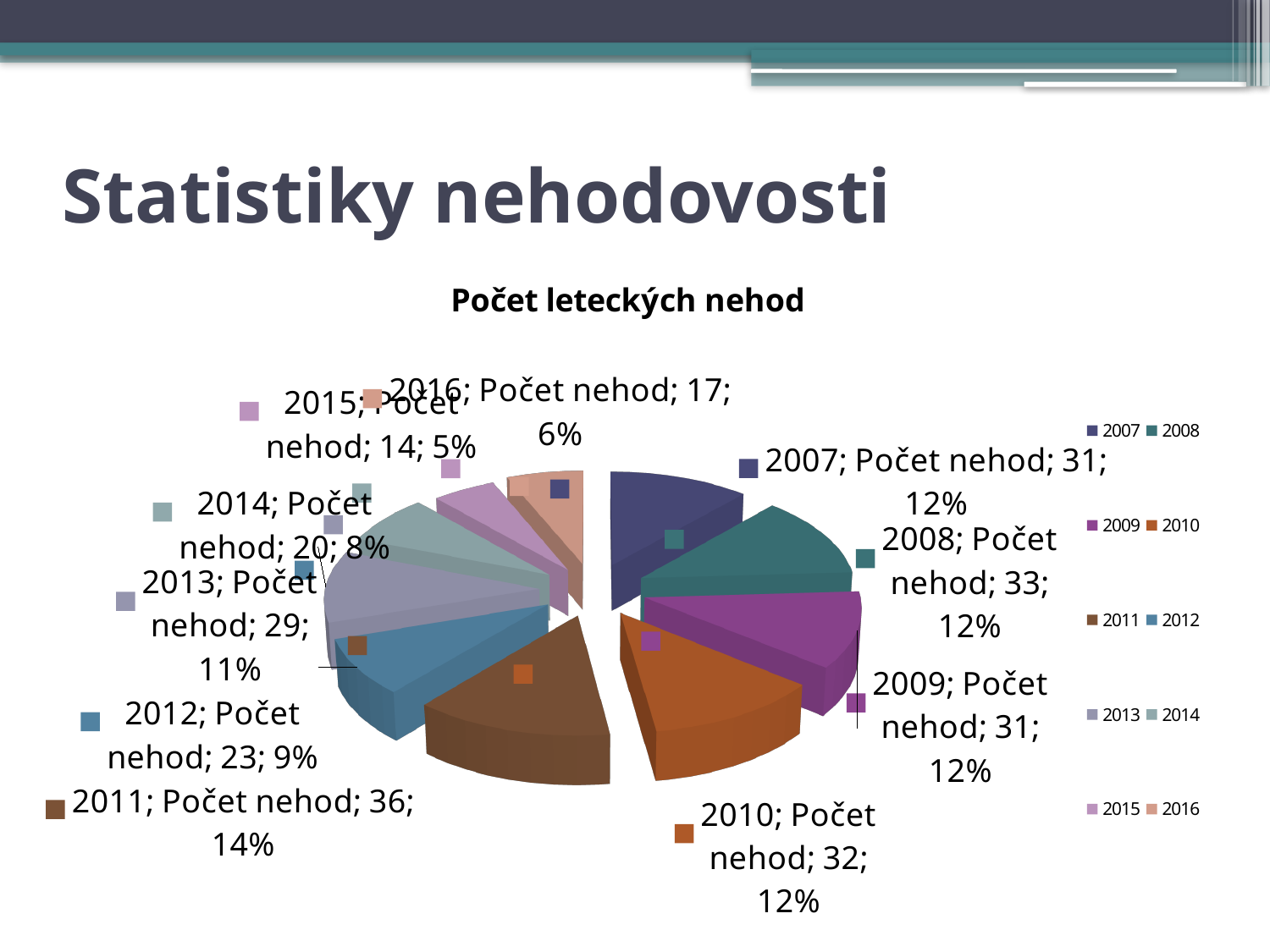
Which year has the lowest number of accidents? 2015 What is the number of accidents (Počet nehod) for 2015? 14 What is the number of accidents (Počet nehod) for 2008? 33 What share of the pie does 2014 represent? 8% Which year has the highest number of accidents? 2011 How many entries does the legend list? 10 What is the difference in the number of accidents between 2011 and 2015? 22 What is the title of the chart? Počet leteckých nehod How many slices (years) does the pie chart have? 10 Which year has more accidents, 2012 or 2013? 2013 What kind of chart is shown on the slide? Pie chart What is the number of accidents (Počet nehod) for 2011? 36